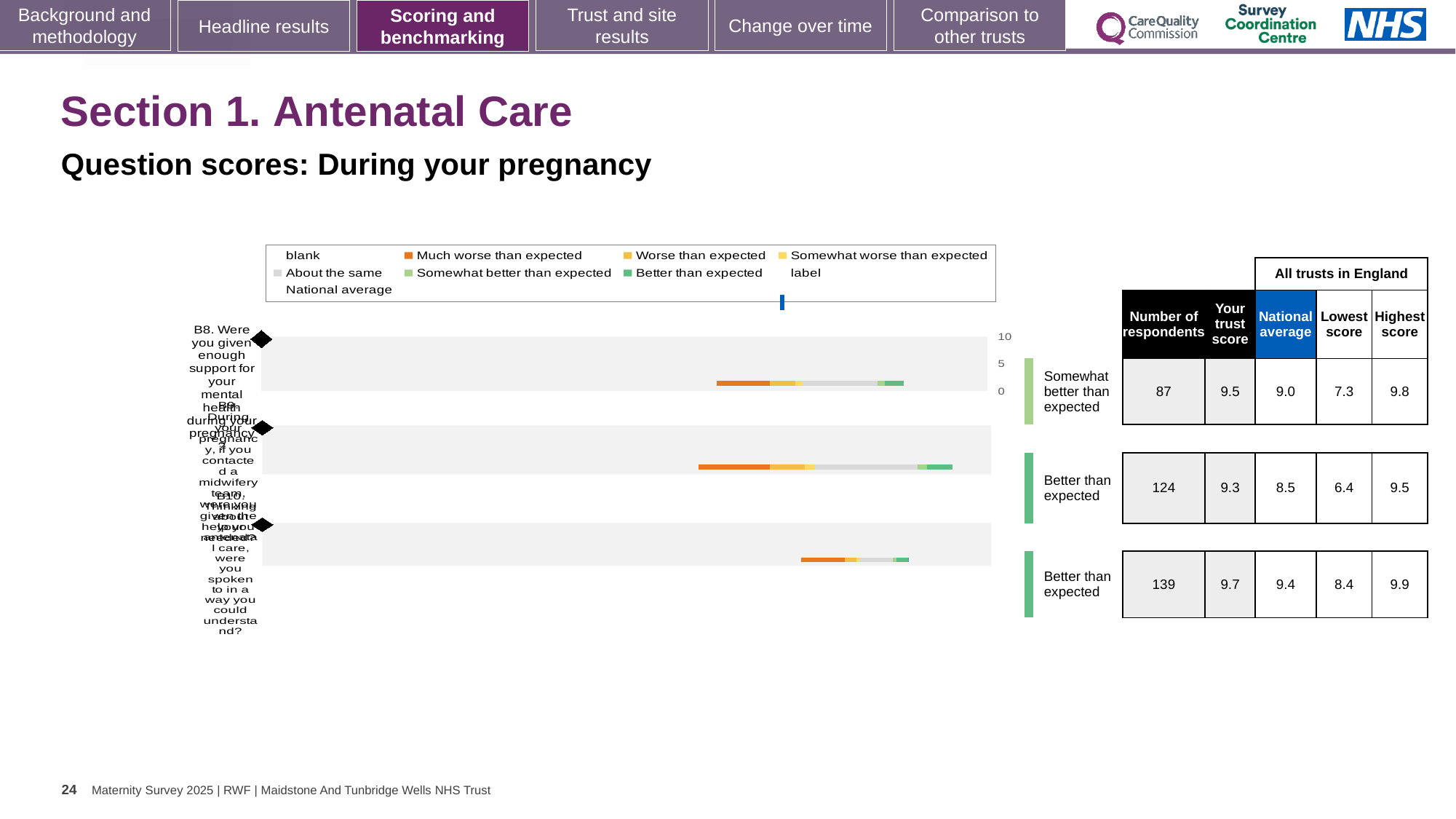
Which row in the table has the lowest value in the 'Lowest score' column? B9 (6.4) Which row in the table has the highest number of respondents? B10 (139) For the second row (B9), what is the difference between the trust score and the national average? 0.8 What kind of chart is shown on the slide? bar chart In the table beside the chart, what is the number of respondents for the first row (B8)? 87 In the table beside the chart, what is the trust score for the third row (B10)? 9.7 In the table, what is the lowest score for the second row (B9)? 6.4 What benchmark category is shown for the first row (B8)? Somewhat better than expected For the first row (B8), which is larger: the trust score or the national average? the trust score (9.5) How many questions (bars) are plotted in the chart? 3 In the table, what is the highest score for the third row (B10)? 9.9 In the legend, what colour represents 'Much worse than expected'? orange